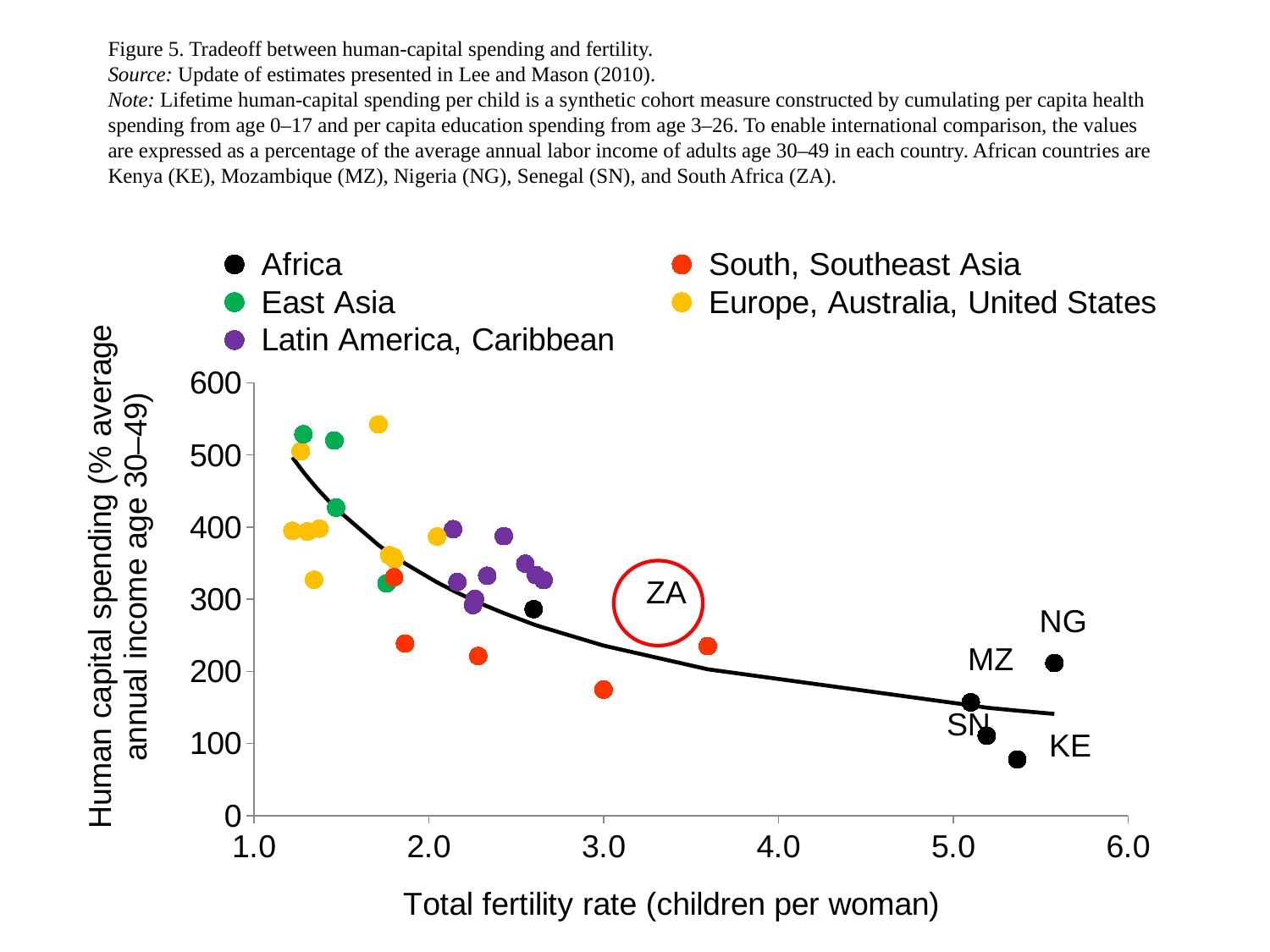
Is the human capital spending value for KE greater or less than 100? less What kind of chart is shown on the slide? scatter chart Is the human capital spending value for NG greater or less than 300? less What is the label of the x axis? Total fertility rate (children per woman) How many series does the legend list? 5 Among the labeled African countries KE, SN, MZ and NG, which has the lowest human capital spending? KE Which colour represents Africa in the legend? black Which has the higher human capital spending, NG or MZ? NG As total fertility rate increases along the x axis, does human capital spending generally rise or fall? fall Is the human capital spending value for SN greater or less than 200? less